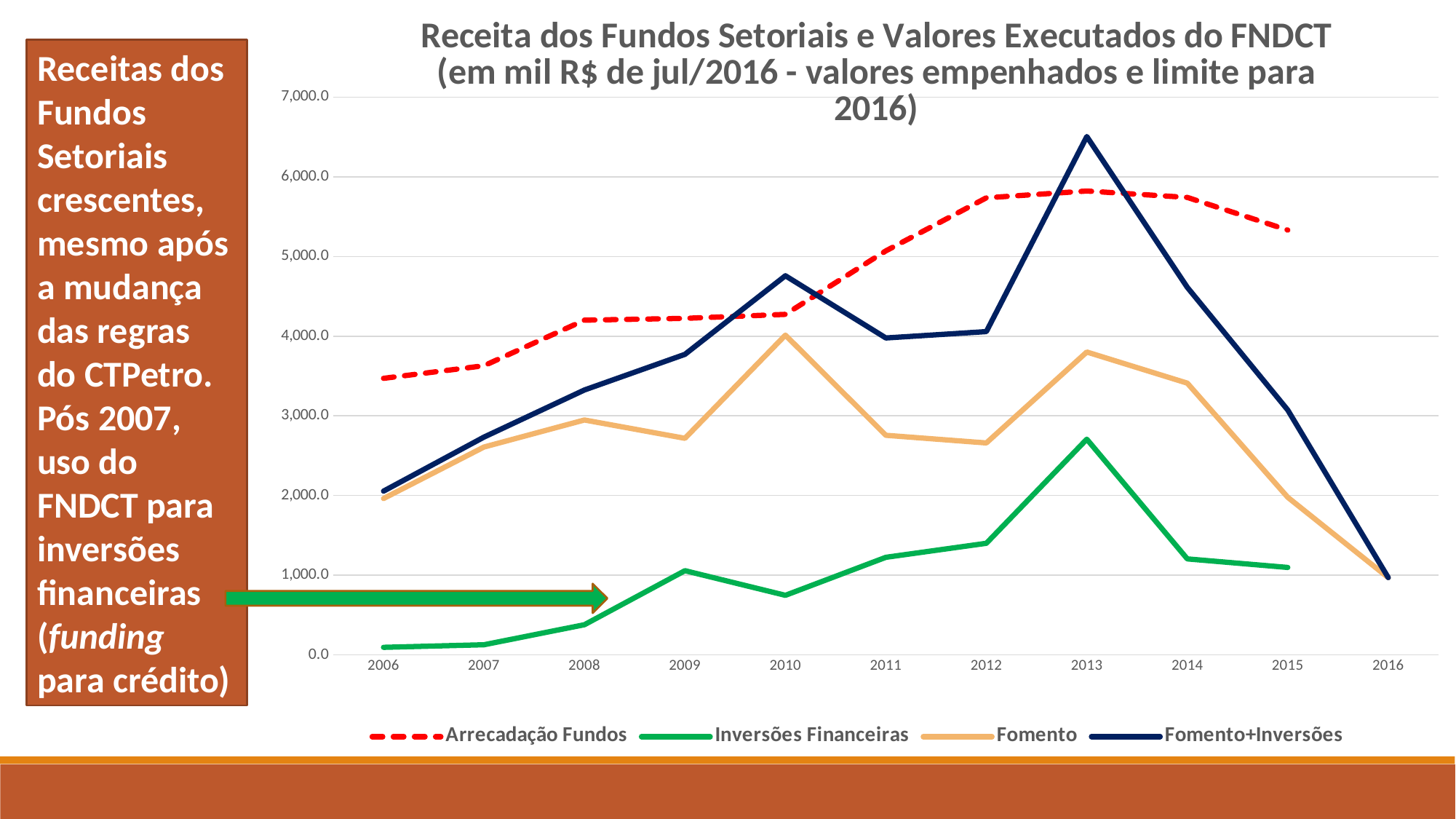
Is the value for Arrecadação Fundos in 2006 greater or less than 4,000.0? less Which series is drawn as a red dashed line? Arrecadação Fundos Does the Fomento+Inversões series rise or fall from 2013 to 2016? fall In which year does the Inversões Financeiras series reach its highest value? 2013 In 2012, which is larger: Arrecadação Fundos or Fomento+Inversões? Arrecadação Fundos Is the value for Fomento+Inversões in 2013 greater or less than 6,000.0? greater In which year does the Fomento series reach its lowest value? 2016 What type of chart is shown on the slide? line chart In which year does the Fomento+Inversões series reach its highest value? 2013 How many series does the legend list? 4 How many years are shown on the x axis? 11 Is the value for Inversões Financeiras in 2013 greater or less than 2,000.0? greater